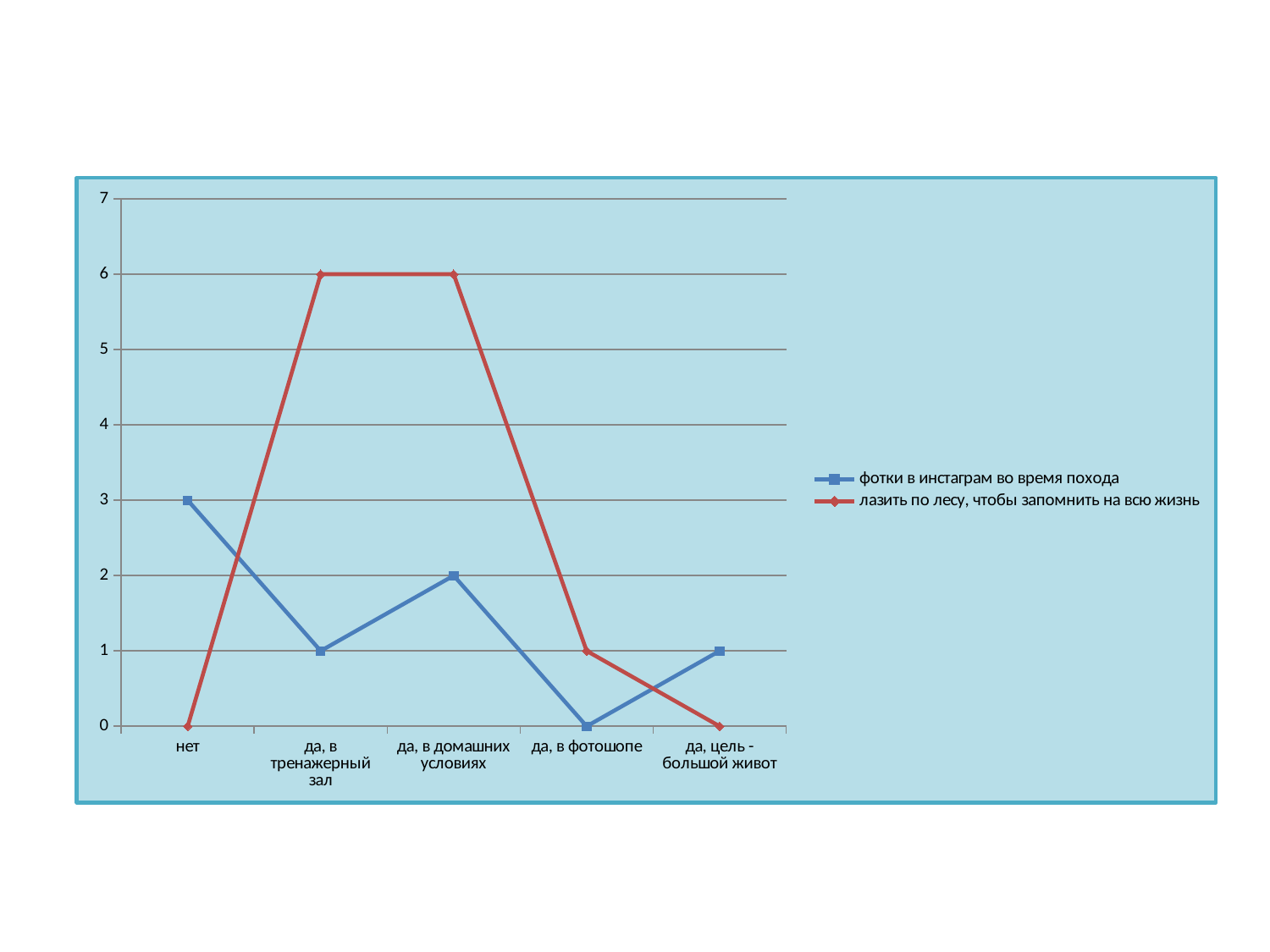
For the category "нет", which series has the larger value? фотки в инстаграм во время похода For which category does the series "фотки в инстаграм во время похода" have its lowest value? да, в фотошопе How many categories are shown on the x axis? 5 What kind of chart is shown on the slide? line chart Which series is drawn in red? лазить по лесу, чтобы запомнить на всю жизнь What is the value of the series "фотки в инстаграм во время похода" for the category "нет"? 3 How many series does the legend list? 2 What is the value of the series "лазить по лесу, чтобы запомнить на всю жизнь" for the category "да, в фотошопе"? 1 What is the value of the series "лазить по лесу, чтобы запомнить на всю жизнь" for the category "да, в тренажерный зал"? 6 What is the difference between the two series for the category "да, в домашних условиях"? 4 What is the value of the series "фотки в инстаграм во время похода" for the category "да, в домашних условиях"? 2 For which category does the series "фотки в инстаграм во время похода" reach its highest value? нет